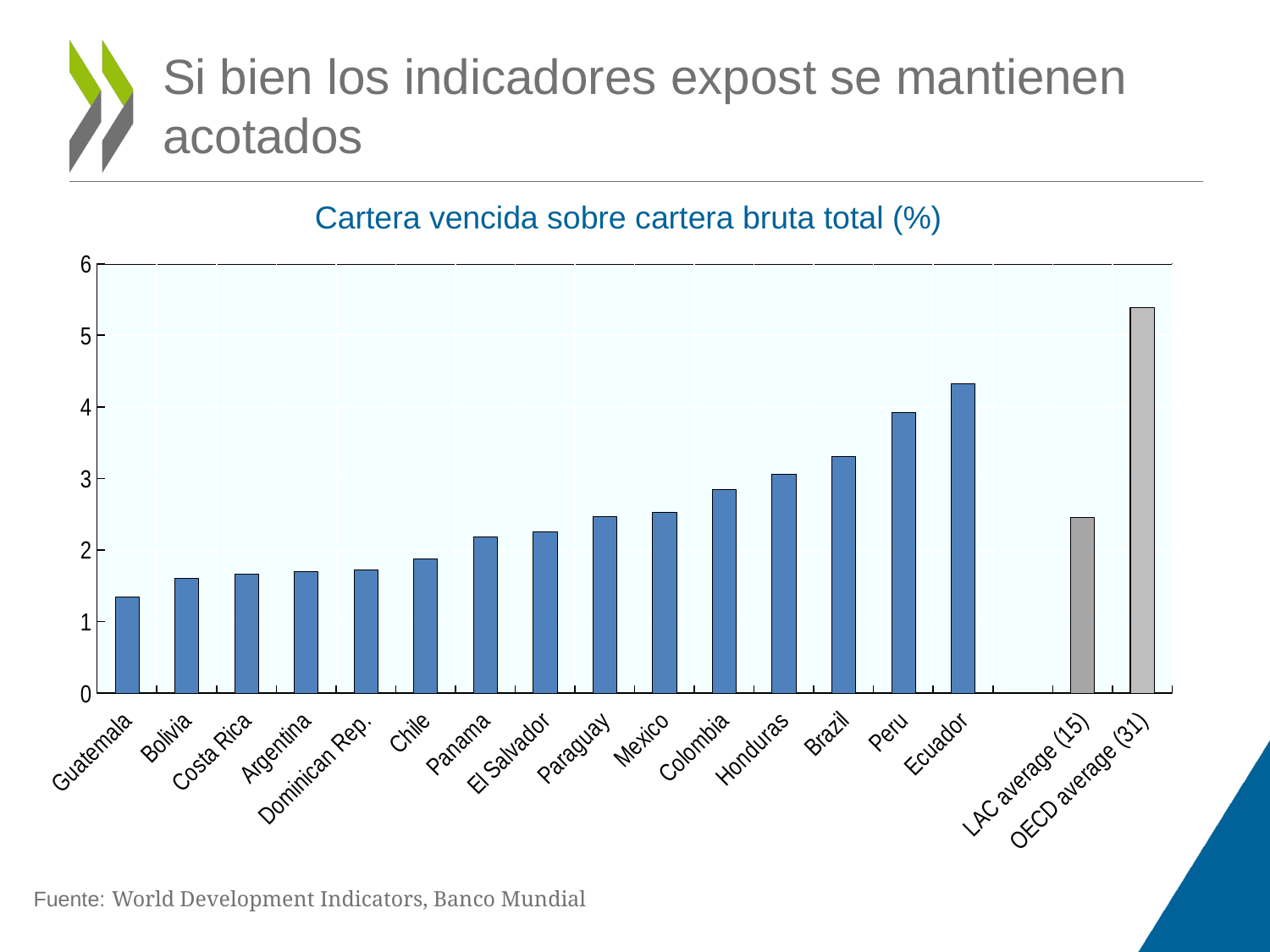
Is the value for Ecuador greater or less than 4? greater Do the values for the countries rise or fall from left to right along the x axis? Rise Which category has the highest value in the chart? OECD average (31) Which country (excluding the averages) has the highest value? Ecuador Which is larger, the value for Ecuador or the value for Peru? Ecuador Which is larger, the value for LAC average (15) or the value for OECD average (31)? OECD average (31) What is the title of the chart? Cartera vencida sobre cartera bruta total (%) Is the value for Chile greater or less than 2? less Is the value for OECD average (31) greater or less than 5? greater What kind of chart is shown on the slide? Bar chart Which category has the lowest value in the chart? Guatemala How many bars are plotted in the chart? 17